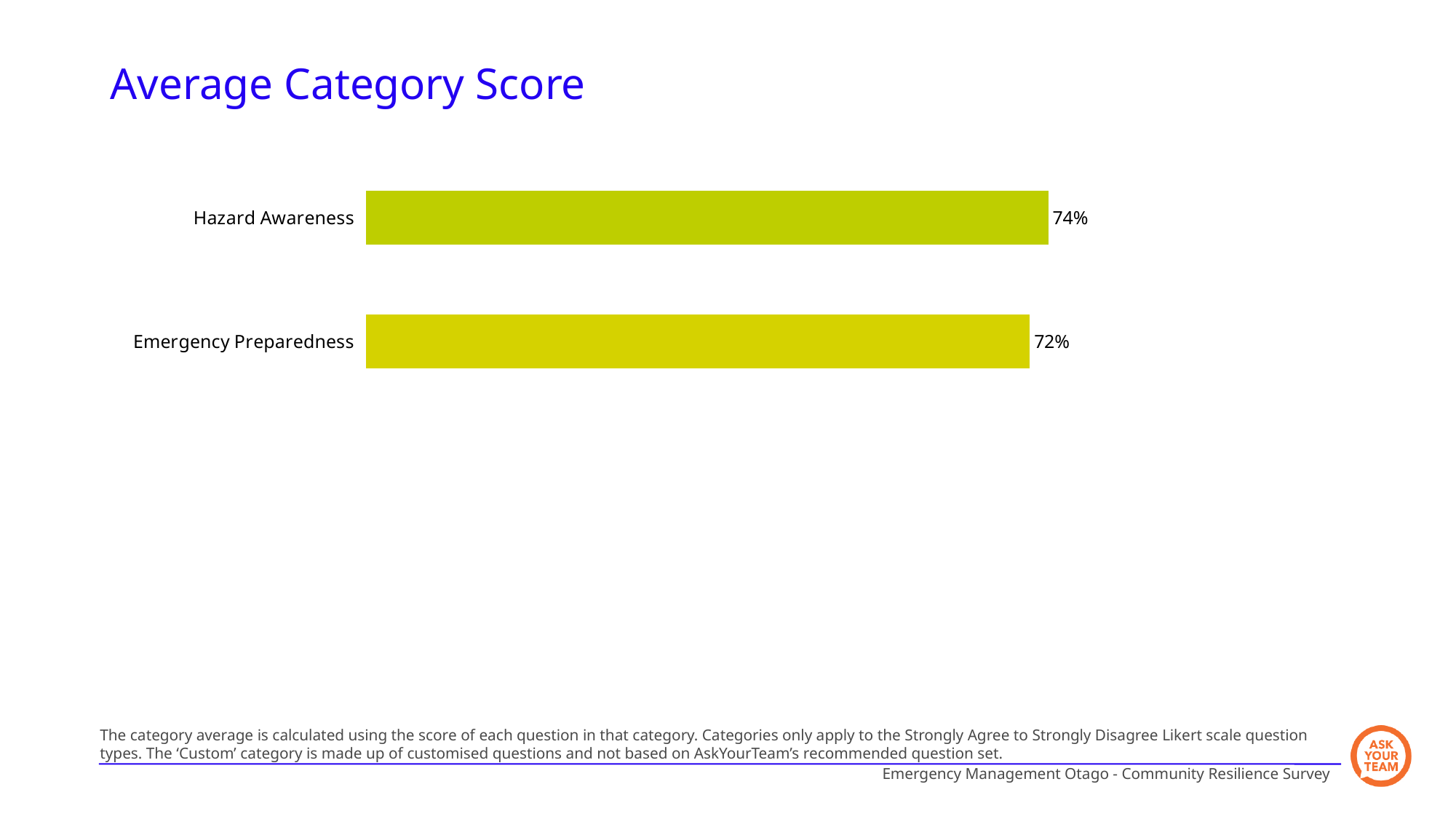
What is the average category score for Emergency Preparedness? 72% What kind of chart is shown on the slide? Bar chart Which category has the highest average score? Hazard Awareness Which is larger, the score for Hazard Awareness or for Emergency Preparedness? Hazard Awareness Which category has the lowest average score? Emergency Preparedness How many categories are shown in the chart? 2 Are the bars in the chart oriented horizontally or vertically? Horizontally What is the title of the chart? Average Category Score What is the difference between the Hazard Awareness and Emergency Preparedness scores? 2% What is the average category score for Hazard Awareness? 74%